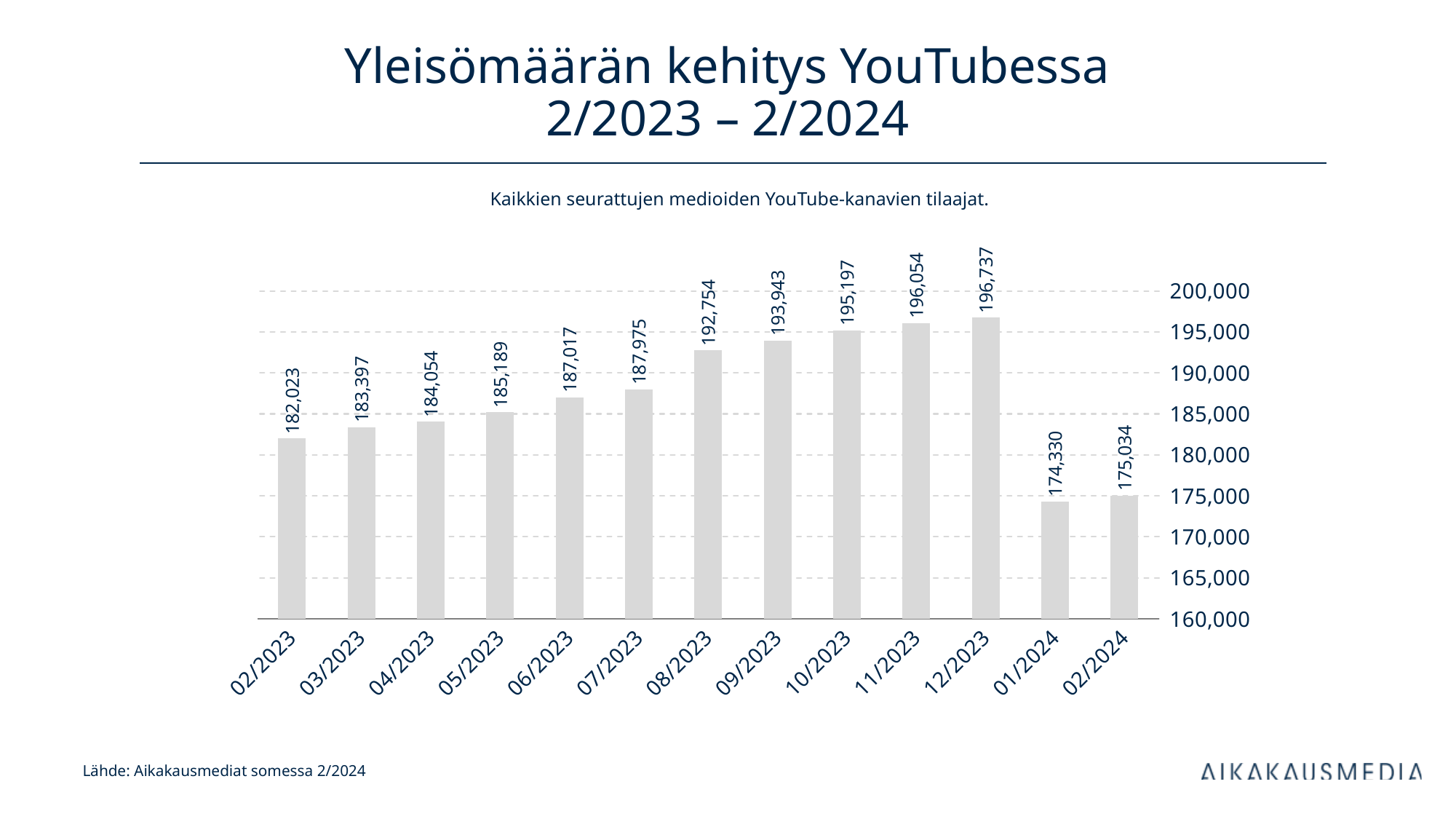
Do the values rise or fall from 02/2023 to 12/2023? Rise What is the difference between the values for 02/2024 and 02/2023? 6,989 Which month has the highest value? 12/2023 What kind of chart is shown on the slide? Bar chart Which is larger, the value for 06/2023 or the value for 07/2023? 07/2023 What is the value for 08/2023? 192,754 What is the value for 12/2023? 196,737 What is the value for 01/2024? 174,330 How many months are shown on the x axis? 13 What is the value for 02/2023? 182,023 What is the difference between the values for 12/2023 and 01/2024? 22,407 Which month has the lowest value? 01/2024